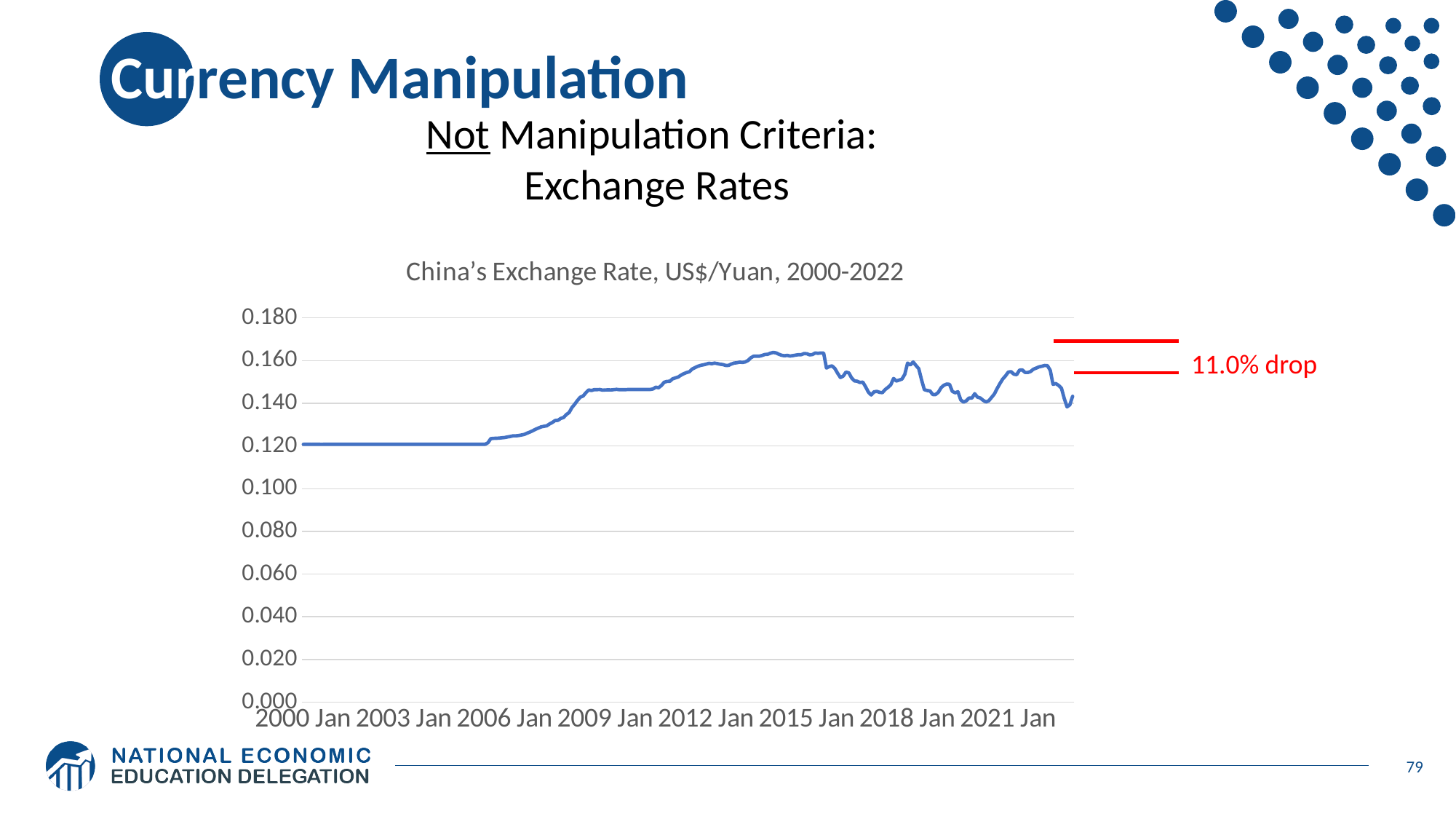
How many lines are plotted on the chart? 1 Which is larger, the exchange rate at 2003 Jan or at 2012 Jan? 2012 Jan Is the exchange rate at 2006 Jan greater or less than 0.140? less What is the title of the chart? China's Exchange Rate, US$/Yuan, 2000-2022 What kind of chart is shown on the slide? line chart Is the exchange rate at 2015 Jan greater or less than 0.140? greater Is the exchange rate at 2000 Jan greater or less than 0.100? greater How many year labels are shown on the x axis? 8 Does the exchange rate rise or fall between 2006 Jan and 2009 Jan? rise What percentage drop is annotated in red on the chart? 11.0% drop